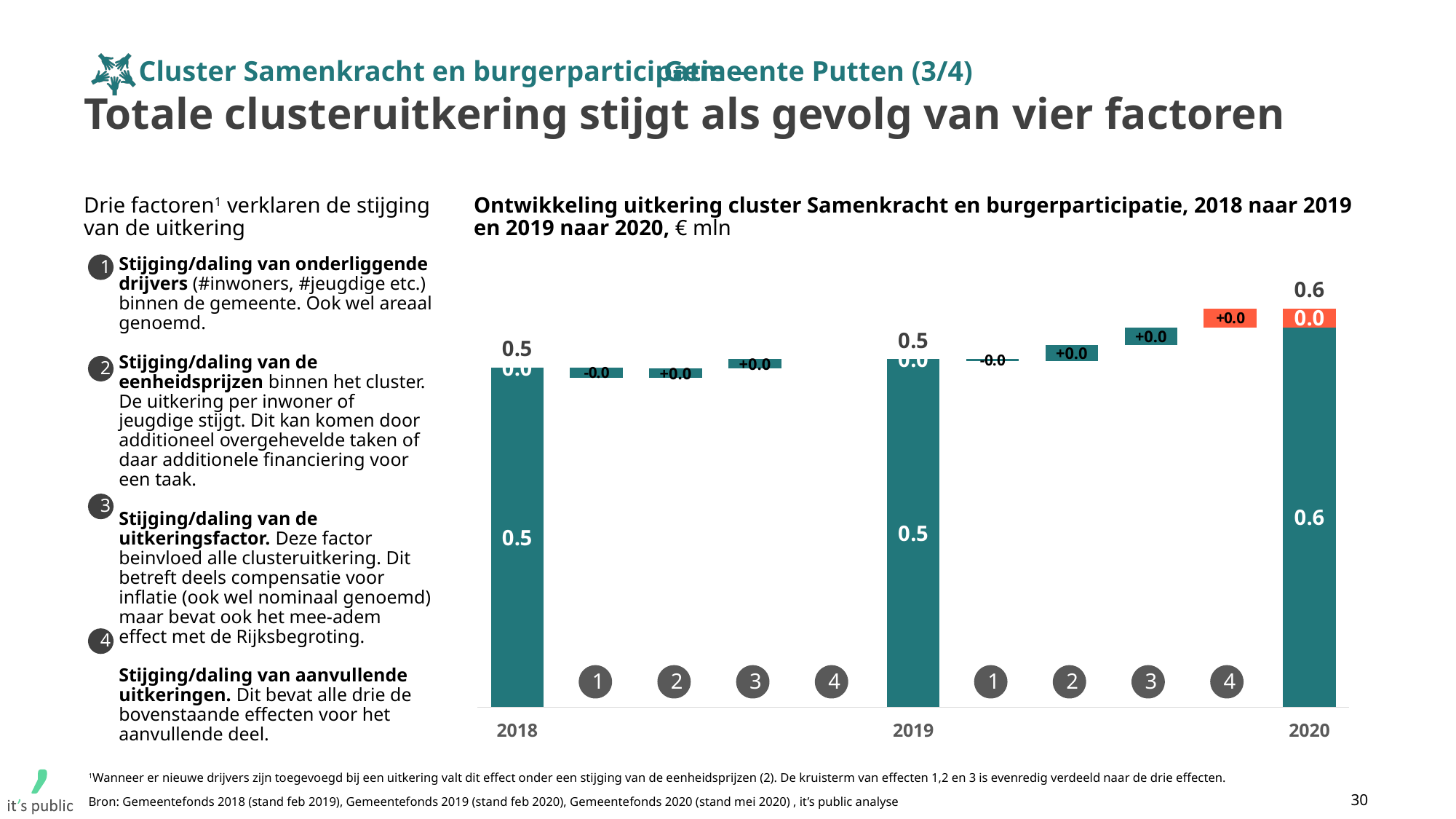
Is the total payout for 2020 larger or smaller than the total payout for 2019? larger What value is printed on the factor 1 bar between 2018 and 2019? -0.0 What is the total cluster payout shown for 2018? 0.5 What is the difference between the total payout in 2020 and in 2018? 0.1 What is the total cluster payout shown for 2019? 0.5 Which year has the highest total cluster payout? 2020 What kind of chart is shown on the slide? Bar chart (waterfall) What value is printed on the factor 4 bar between 2019 and 2020? +0.0 In what unit are the values in the chart expressed, according to the chart title? € mln What is the total cluster payout shown for 2020? 0.6 How many year totals are shown on the x axis of the chart? 3 What colour is the factor 4 bar between 2019 and 2020? Orange